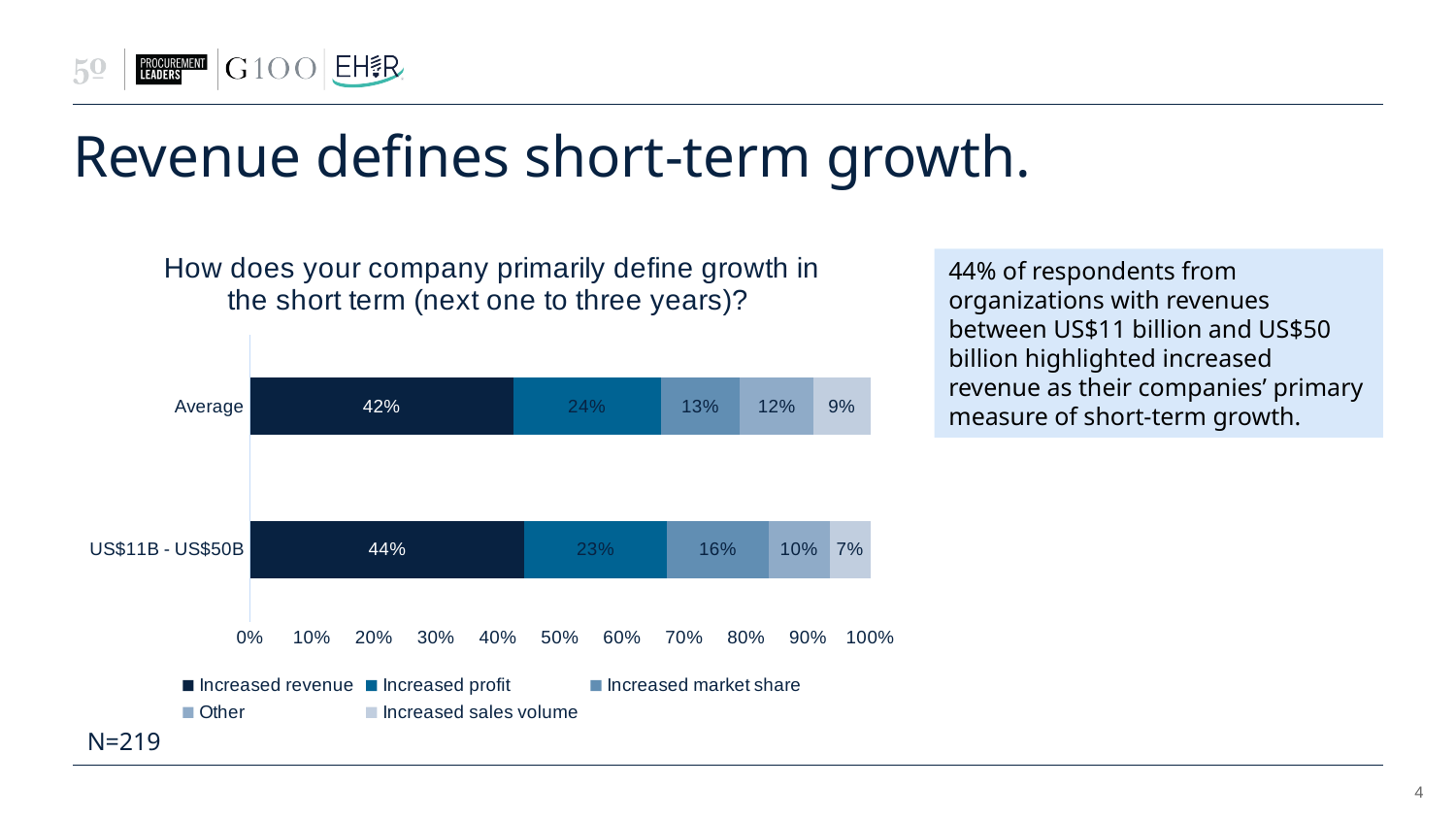
Which series has the lowest value in the US$11B - US$50B bar? Increased sales volume What percentage of respondents in the Average category chose Increased revenue? 42% What is the Increased revenue value for the US$11B - US$50B category? 44% What is the Increased market share value for the US$11B - US$50B category? 16% How many series does the legend list? 5 What is the difference between the Increased revenue values for US$11B - US$50B and Average? 2% What kind of chart is shown on the slide? Stacked bar chart Which category has the larger Increased market share value, Average or US$11B - US$50B? US$11B - US$50B Which series has the highest value in the Average bar? Increased revenue What is the sample size (N) shown on the slide? N=219 What is the Increased profit value for the Average category? 24% What is the Increased sales volume value for the US$11B - US$50B category? 7%